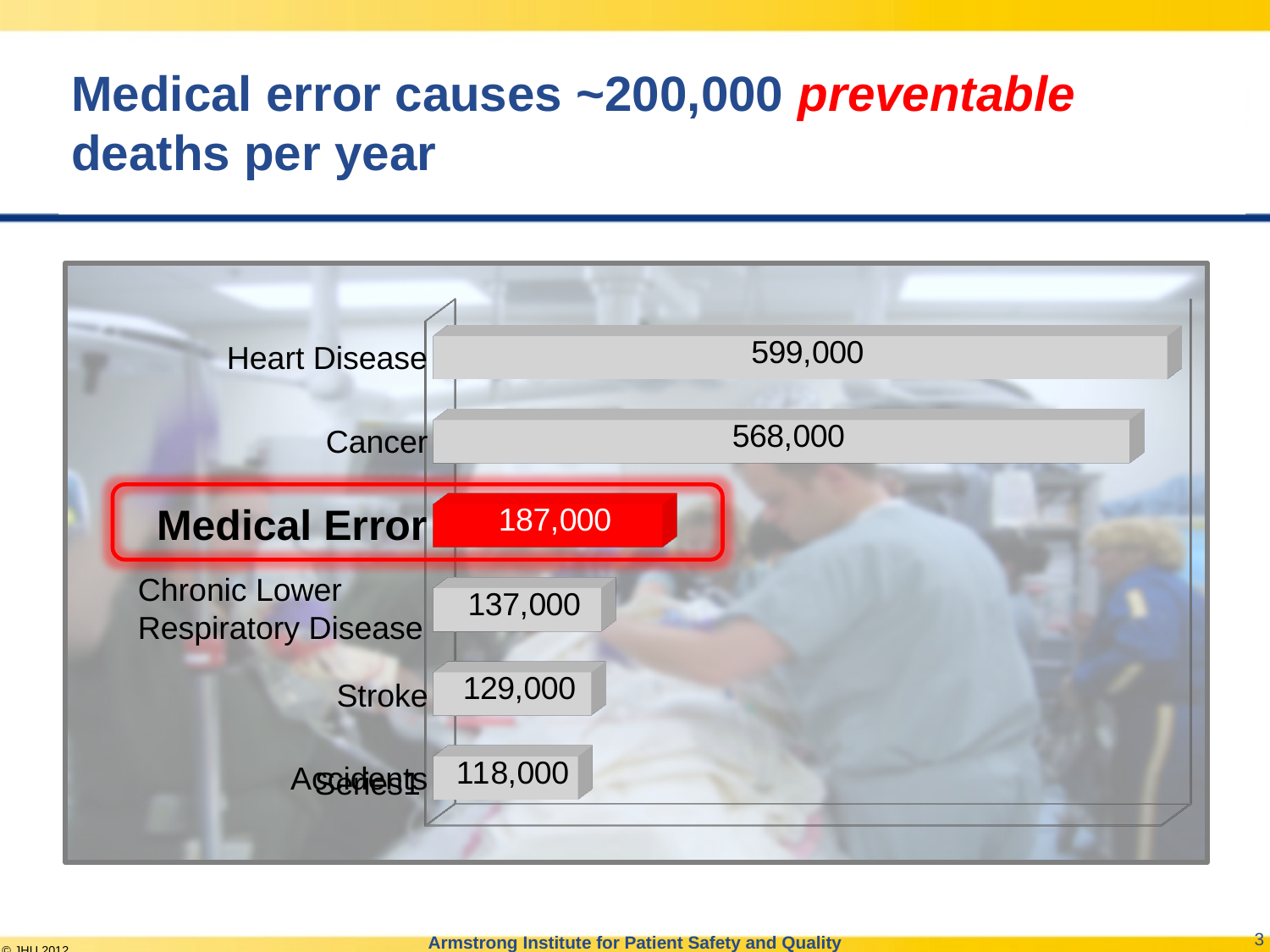
Which is larger, the value for Medical Error or the value for Chronic Lower Respiratory Disease? Medical Error What value is shown for Medical Error? 187,000 How many categories are shown in the chart? 6 What value is shown for Accidents? 118,000 What value is shown for Stroke? 129,000 What is the difference between the values for Heart Disease and Cancer? 31,000 What value is shown for Cancer? 568,000 Which category has the highest value? Heart Disease What value is shown for Chronic Lower Respiratory Disease? 137,000 What value is shown for Heart Disease? 599,000 Which category has the lowest value? Accidents What is the difference between the values for Medical Error and Stroke? 58,000